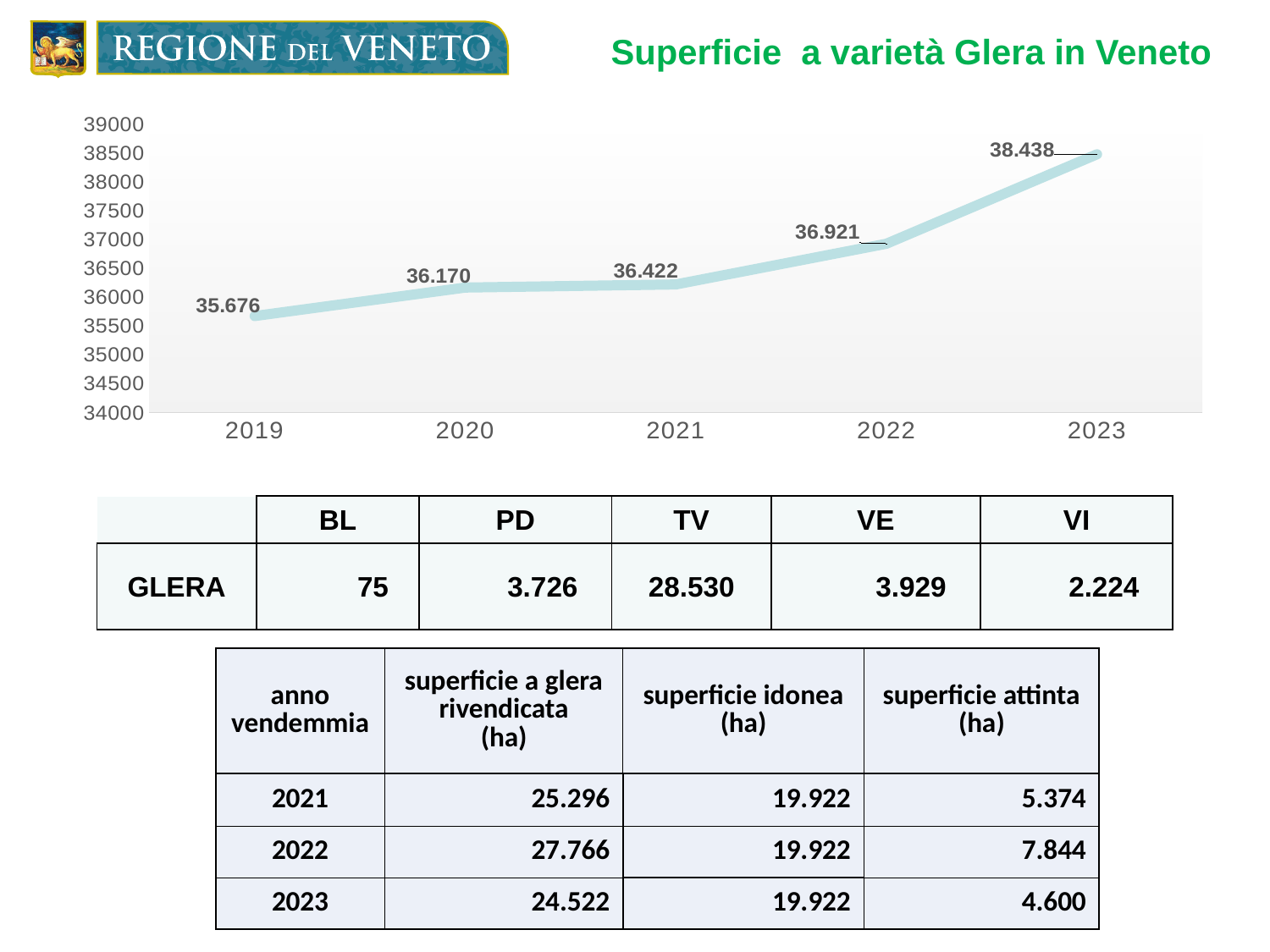
What kind of chart is shown on the slide? line chart How many years are plotted on the x axis of the line chart? 5 What is the difference between the 2020 value and the 2019 value in the line chart? 494 What is the value plotted for 2019 in the line chart? 35.676 Is the value for 2022 in the line chart greater or less than 37000? less Which is larger in the line chart, the value for 2022 or the value for 2021? 2022 Do the values in the line chart rise or fall from 2019 to 2023? rise What is the value plotted for 2021 in the line chart? 36.422 What is the value plotted for 2023 in the line chart? 38.438 Which year has the lowest value in the line chart? 2019 Which year has the highest value in the line chart? 2023 What is the difference between the 2023 value and the 2022 value in the line chart? 1.517